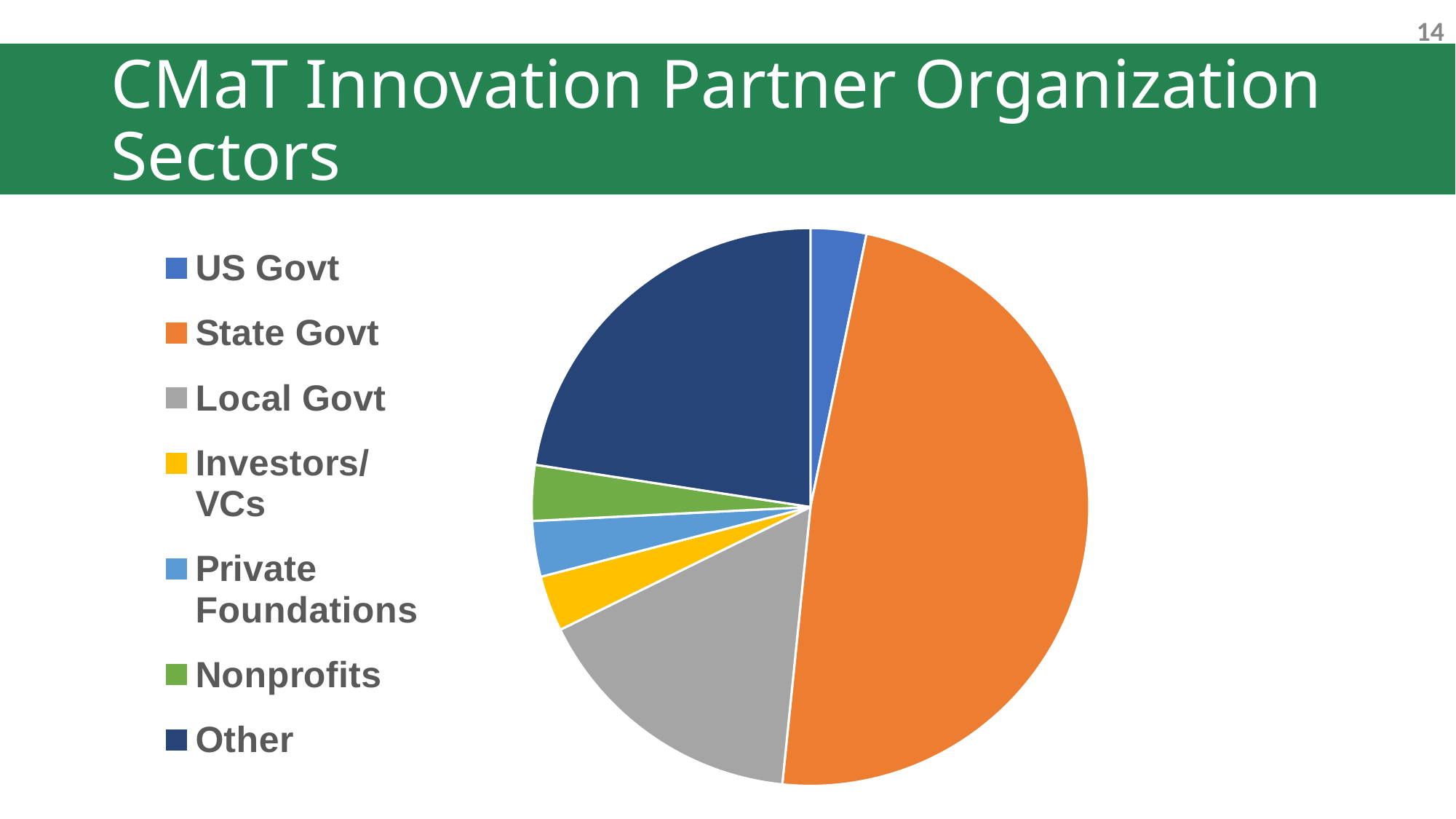
Which slice is larger, Other or Nonprofits? Other Which slice is larger, State Govt or Other? State Govt Which slice is larger, Local Govt or Nonprofits? Local Govt Which sector has the largest slice of the pie chart? State Govt How many sectors (categories) does the pie chart show? 7 What is the title of the slide containing the pie chart? CMaT Innovation Partner Organization Sectors What colour is the State Govt slice in the pie chart? orange What kind of chart is shown on the slide? pie chart